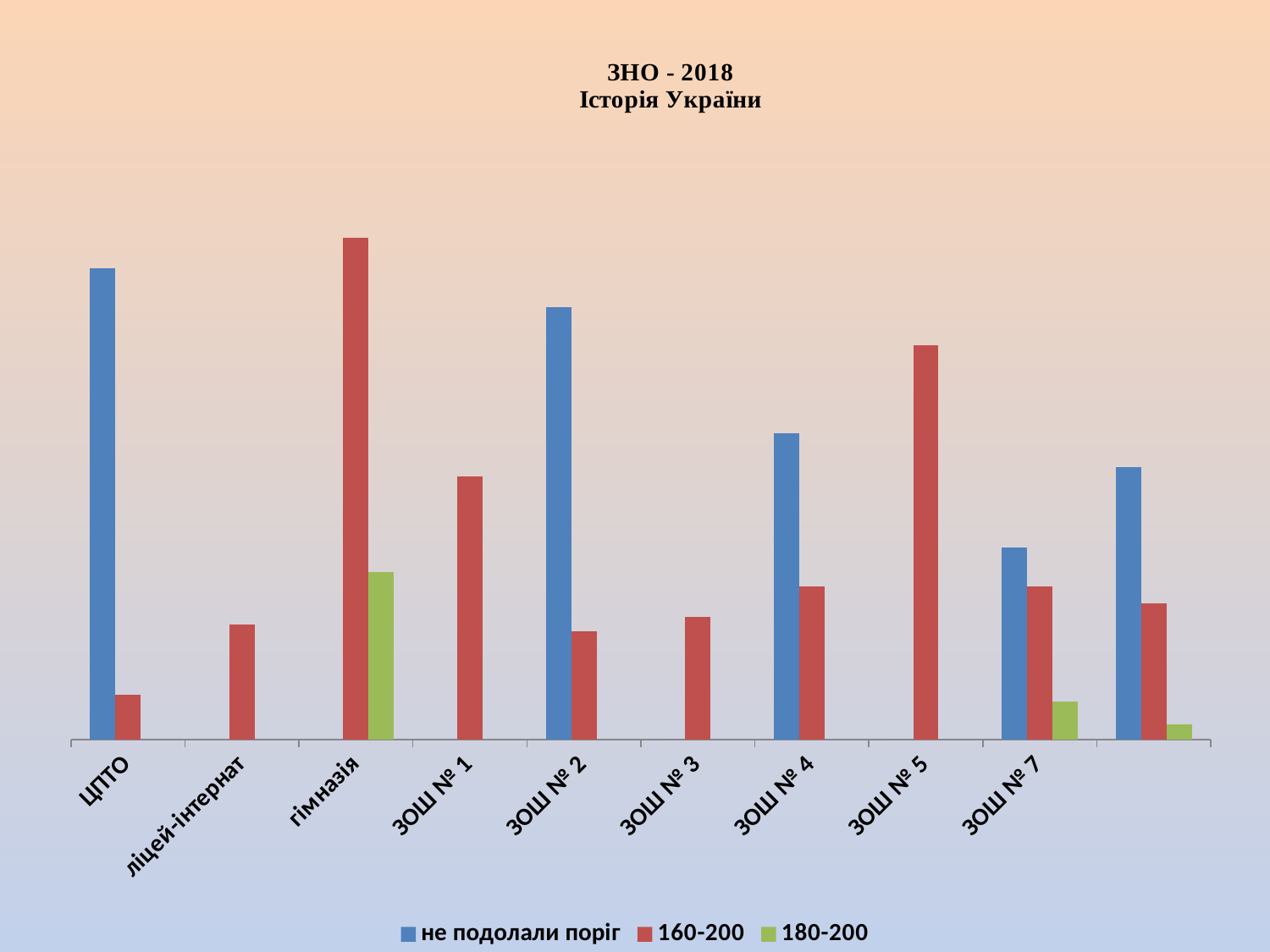
Which category has the tallest bar for the series 160-200? гімназія Which category has the shortest bar for the series 160-200? ЦПТО What is the title of the chart? ЗНО - 2018 Історія України How many series does the legend list? 3 Which series is shown in green in the legend? 180-200 For the series 160-200, which is larger: ЗОШ № 5 or ЗОШ № 4? ЗОШ № 5 Which category has the tallest bar for the series 180-200? гімназія For the series 'не подолали поріг', which is larger: ЗОШ № 4 or ЗОШ № 7? ЗОШ № 4 Which category has the tallest bar for the series 'не подолали поріг'? ЦПТО What kind of chart is shown on the slide? bar chart For the series 'не подолали поріг', which is larger: ЦПТО or ЗОШ № 2? ЦПТО